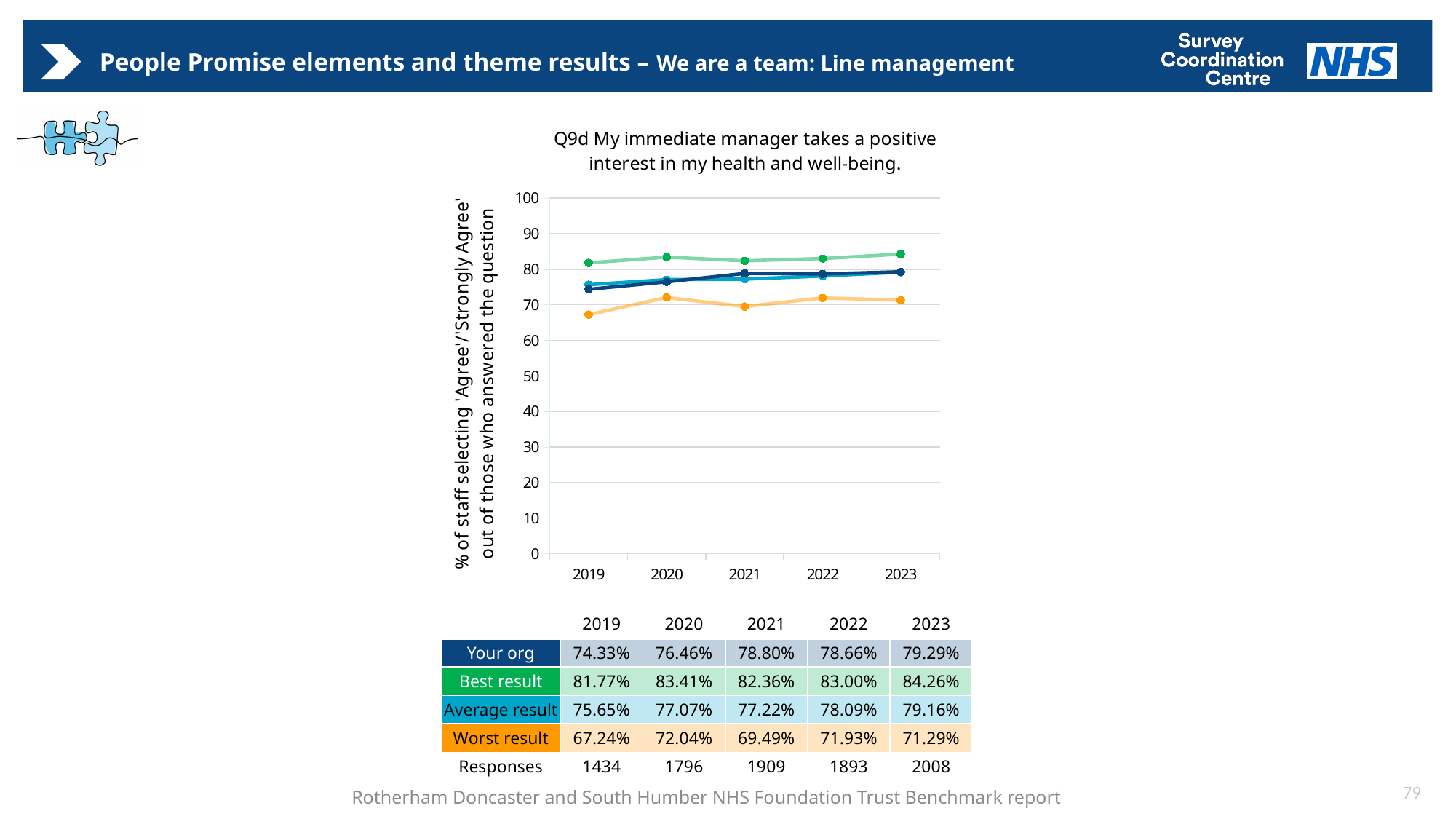
What is the value for Your org in 2021? 78.80% What is the Average result value in 2023? 79.16% What kind of chart is shown on the slide? line chart What is the Worst result value in 2019? 67.24% Does the Your org series overall rise or fall from 2019 to 2023? rise How many years are plotted on the x axis? 5 Which is larger in 2022, Your org or the Average result? Your org How many series are plotted on the chart? 4 Is the Best result value for 2020 greater or less than 80? greater In which year is the Worst result lowest? 2019 In which year is the Best result highest? 2023 What is the difference between the Best result and the Worst result in 2023? 12.97 percentage points